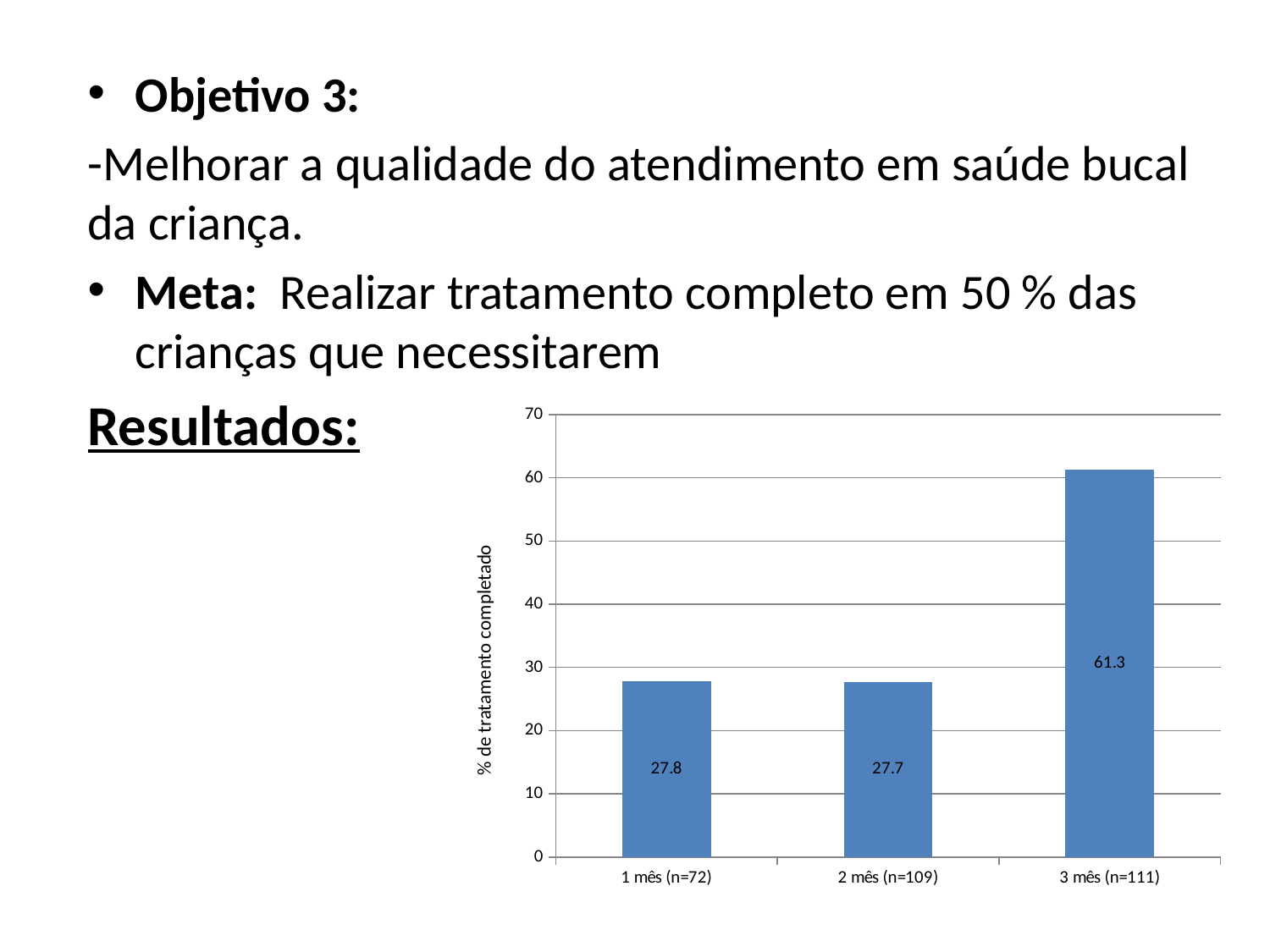
Is the value for 1 mês (n=72) greater or less than 30? less What is the difference between the values for 1 mês (n=72) and 2 mês (n=109)? 0.1 Which is larger, the value for 3 mês (n=111) or the value for 2 mês (n=109)? 3 mês (n=111) How many categories are shown on the x axis? 3 Is the value for 3 mês (n=111) greater or less than 50? greater What is the value for 3 mês (n=111)? 61.3 What is the value for 2 mês (n=109)? 27.7 What kind of chart is shown on the slide? bar chart What is the value for 1 mês (n=72)? 27.8 Which category has the highest value? 3 mês (n=111) What is the difference between the values for 3 mês (n=111) and 1 mês (n=72)? 33.5 What is the label of the vertical axis? % de tratamento completado